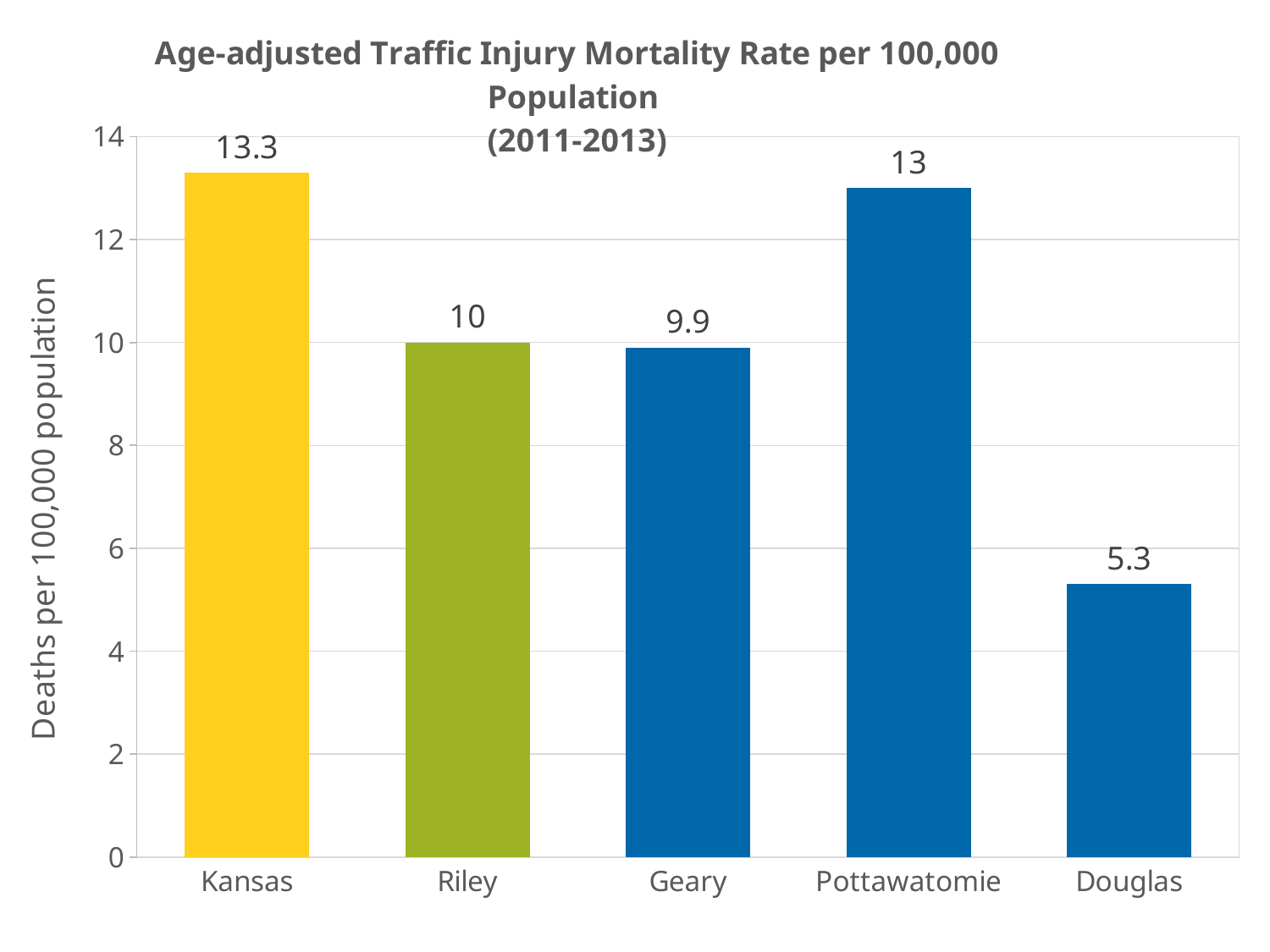
Is the value for Douglas greater or less than 6? less What is the age-adjusted traffic injury mortality rate for Douglas? 5.3 What kind of chart is shown on the slide? bar chart What is the difference between the values for Kansas and Douglas? 8 What is the label of the y axis? Deaths per 100,000 population What is the difference between the values for Pottawatomie and Riley? 3 Which has a higher mortality rate, Pottawatomie or Geary? Pottawatomie How many categories are shown on the x axis? 5 Which category has the highest traffic injury mortality rate? Kansas Which category has the lowest traffic injury mortality rate? Douglas What is the age-adjusted traffic injury mortality rate for Kansas? 13.3 What is the value shown for Geary? 9.9